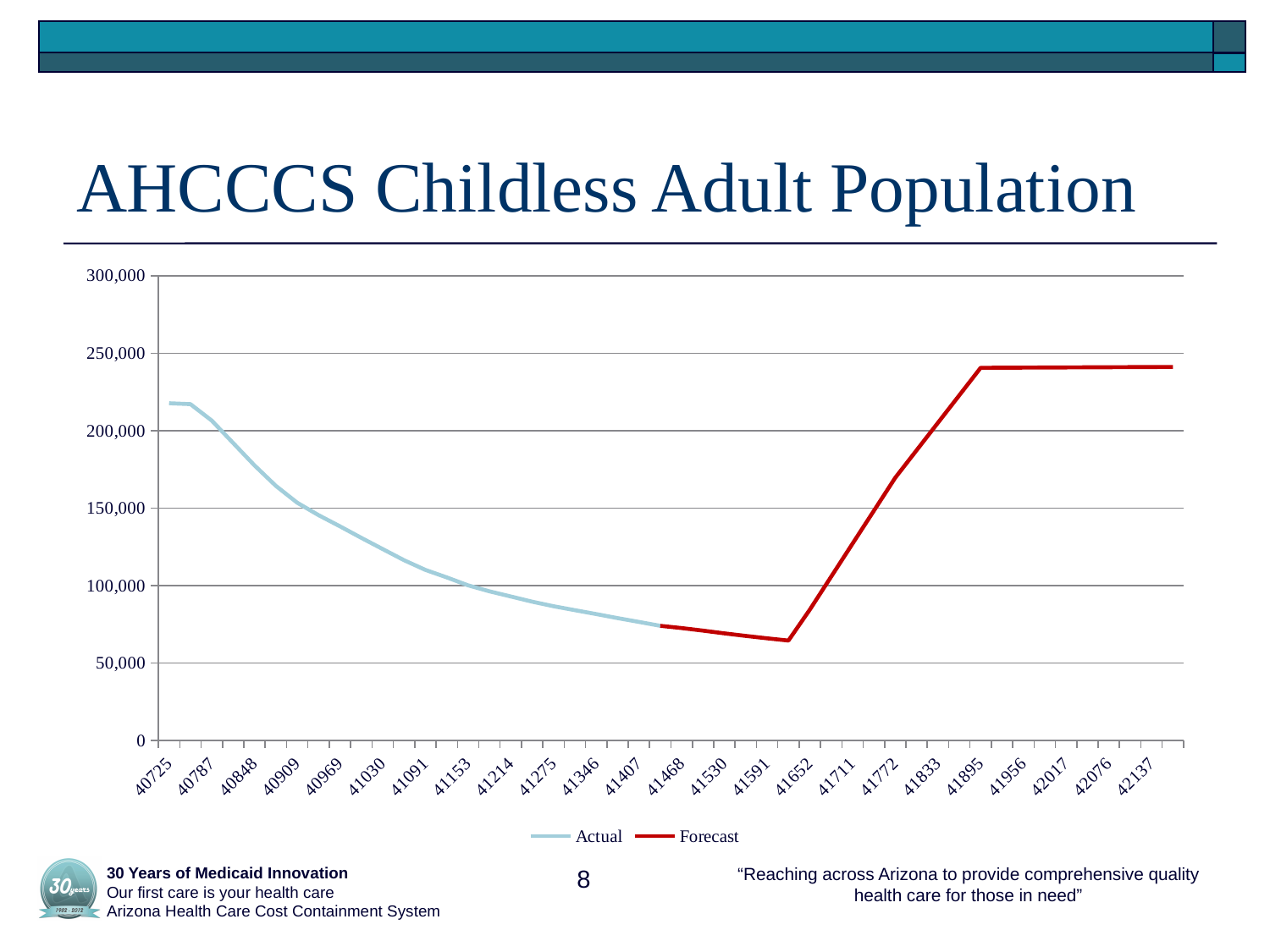
How many points are labelled along the x axis? 24 What is the title of the slide containing the chart? AHCCCS Childless Adult Population Is the value at 42137 greater or less than 250,000? less What are the two series named in the legend? Actual and Forecast How many series does the legend list? 2 What kind of chart is shown on the slide? line chart Is the value at 41591 greater or less than 100,000? less Is the value at 40725 greater or less than 200,000? greater Which is larger, the value at 40725 or the value at 41591? 40725 Do the values of the Actual series rise or fall along the x axis? fall